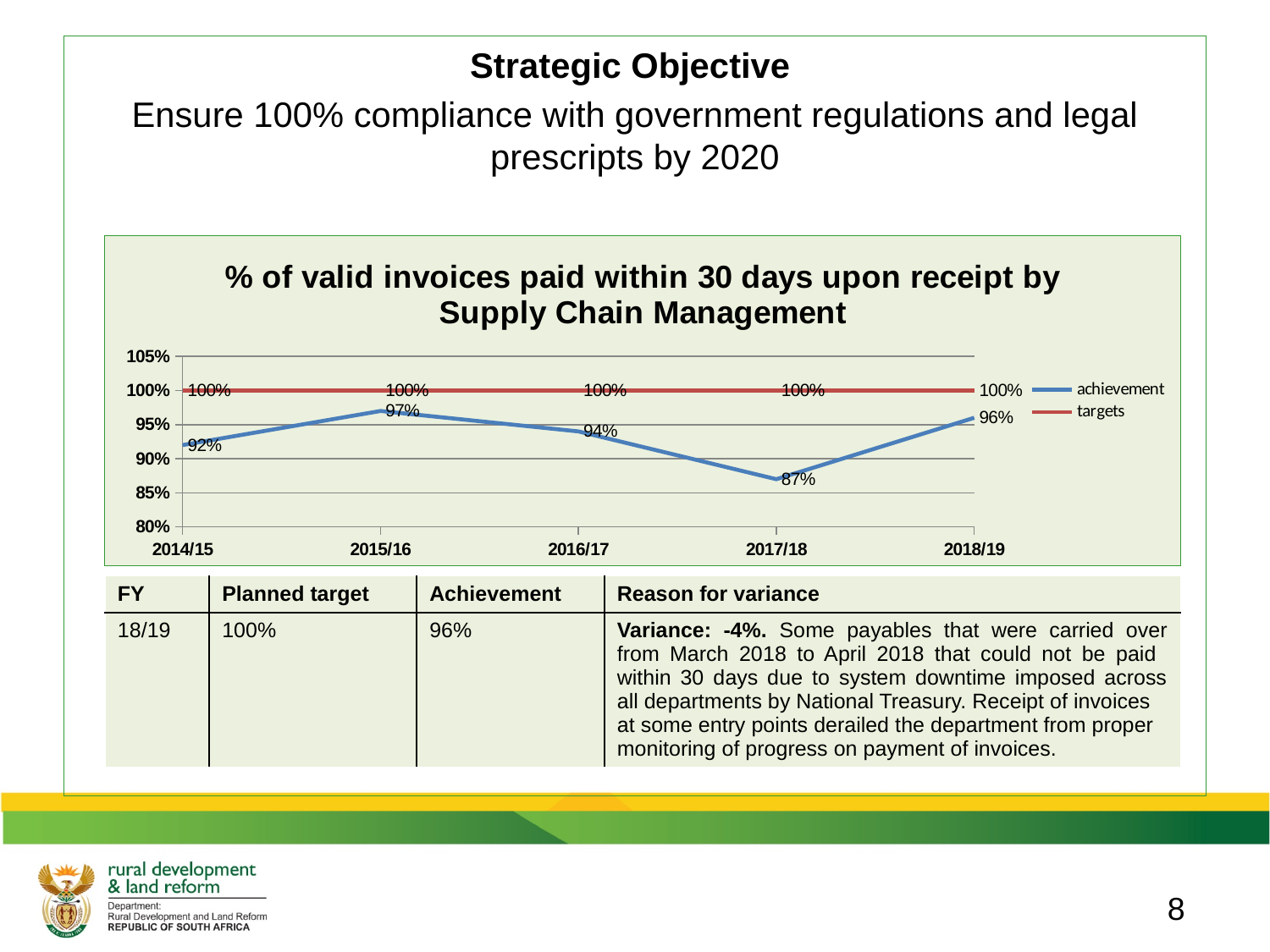
Does the achievement value rise or fall from 2015/16 to 2017/18? fall What is the achievement value for 2014/15? 92% What is the targets value for 2016/17? 100% What is the difference between the targets value and the achievement value for 2018/19? 4% What is the difference between the achievement values for 2015/16 and 2017/18? 10% What is the achievement value for 2017/18? 87% How many financial years are shown on the x axis? 5 Which financial year has the highest achievement value? 2015/16 Which is larger, the achievement value for 2016/17 or for 2018/19? 2018/19 How many series does the legend list? 2 Which financial year has the lowest achievement value? 2017/18 What kind of chart is shown on the slide? line chart